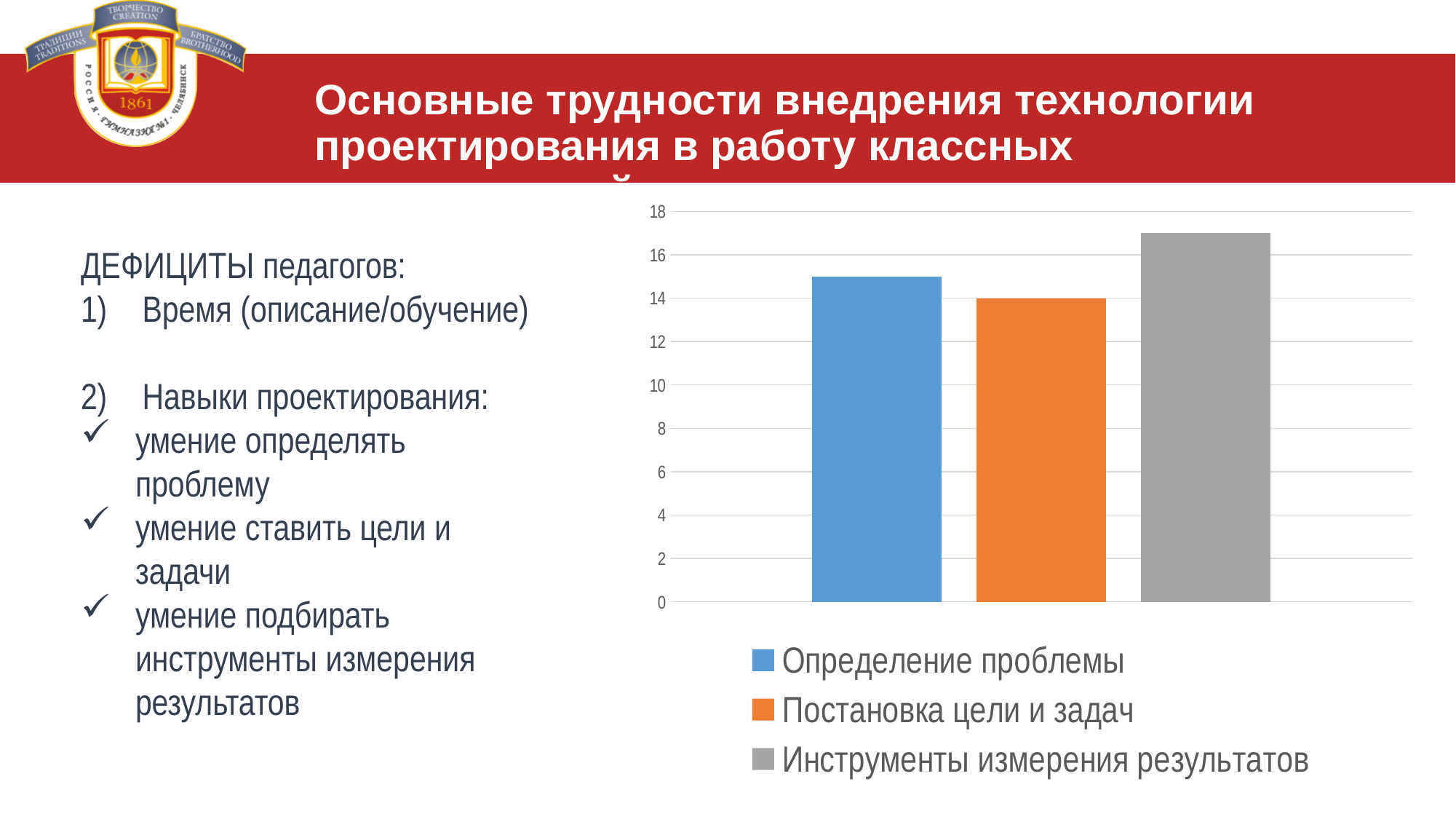
Which is larger, the bar for Инструменты измерения результатов or the bar for Определение проблемы? Инструменты измерения результатов Which series has the highest bar in the chart? Инструменты измерения результатов Which is larger, the bar for Определение проблемы or the bar for Постановка цели и задач? Определение проблемы Which series has the lowest bar in the chart? Постановка цели и задач What is the value for Постановка цели и задач? 14 What kind of chart is shown on the slide? bar chart What colour is the bar for Постановка цели и задач? orange Is the value for Определение проблемы greater or less than 16? less Is the value for Определение проблемы greater or less than 14? greater How many bars are plotted in the chart? 3 How many entries does the chart legend list? 3 Is the value for Инструменты измерения результатов greater or less than 16? greater